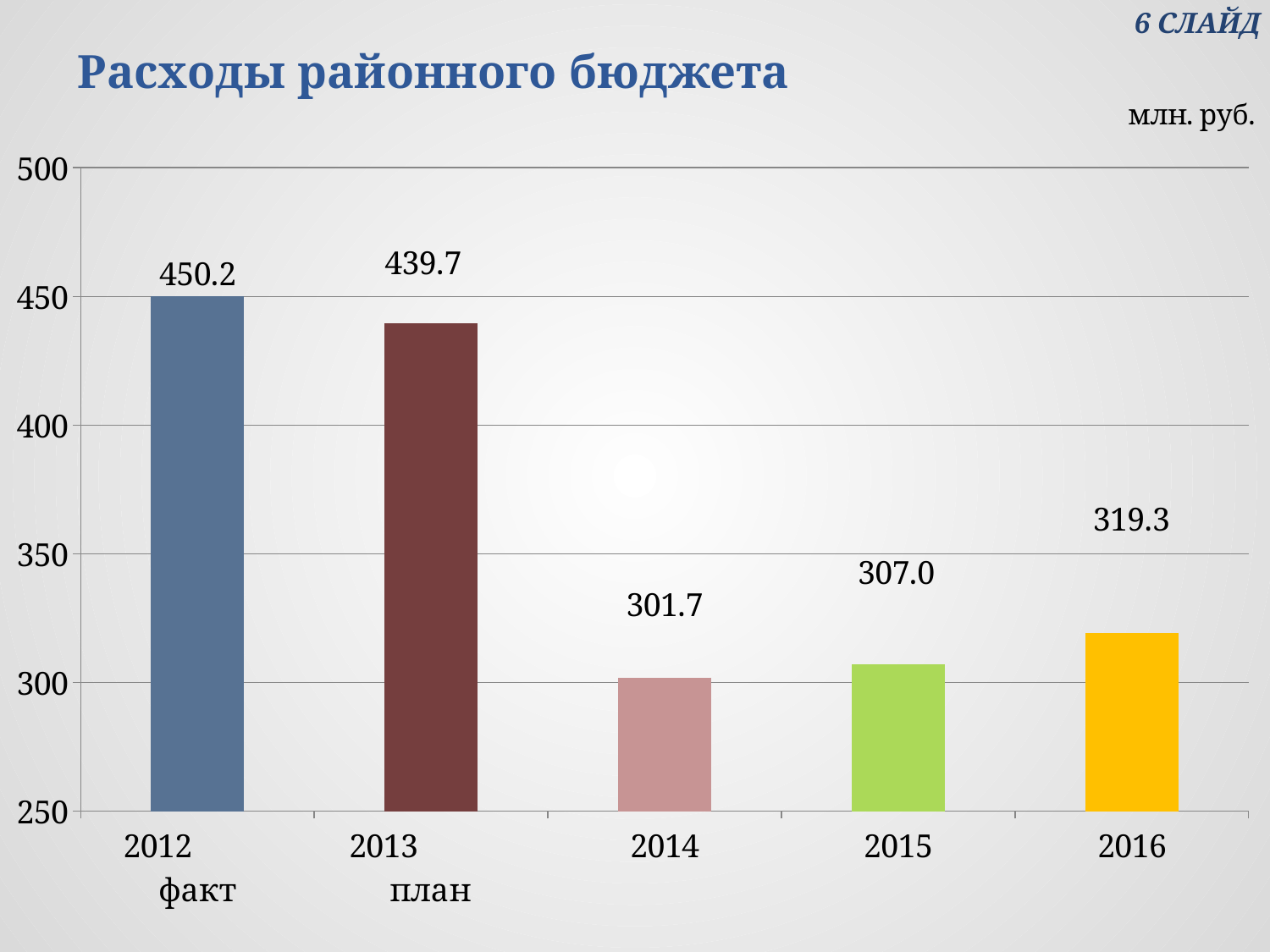
What is the difference between the values for 2016 and 2015? 12.3 What is the difference between the values for 2012 факт and 2013 план? 10.5 Which category has the highest value? 2012 факт Which is larger, the value for 2015 or the value for 2016? 2016 How many categories are shown on the x axis? 5 What is the title of the chart? Расходы районного бюджета What is the value for 2014? 301.7 What kind of chart is this? bar chart Which category has the lowest value? 2014 What is the value for 2016? 319.3 What is the value for 2012 факт? 450.2 What is the value for 2013 план? 439.7